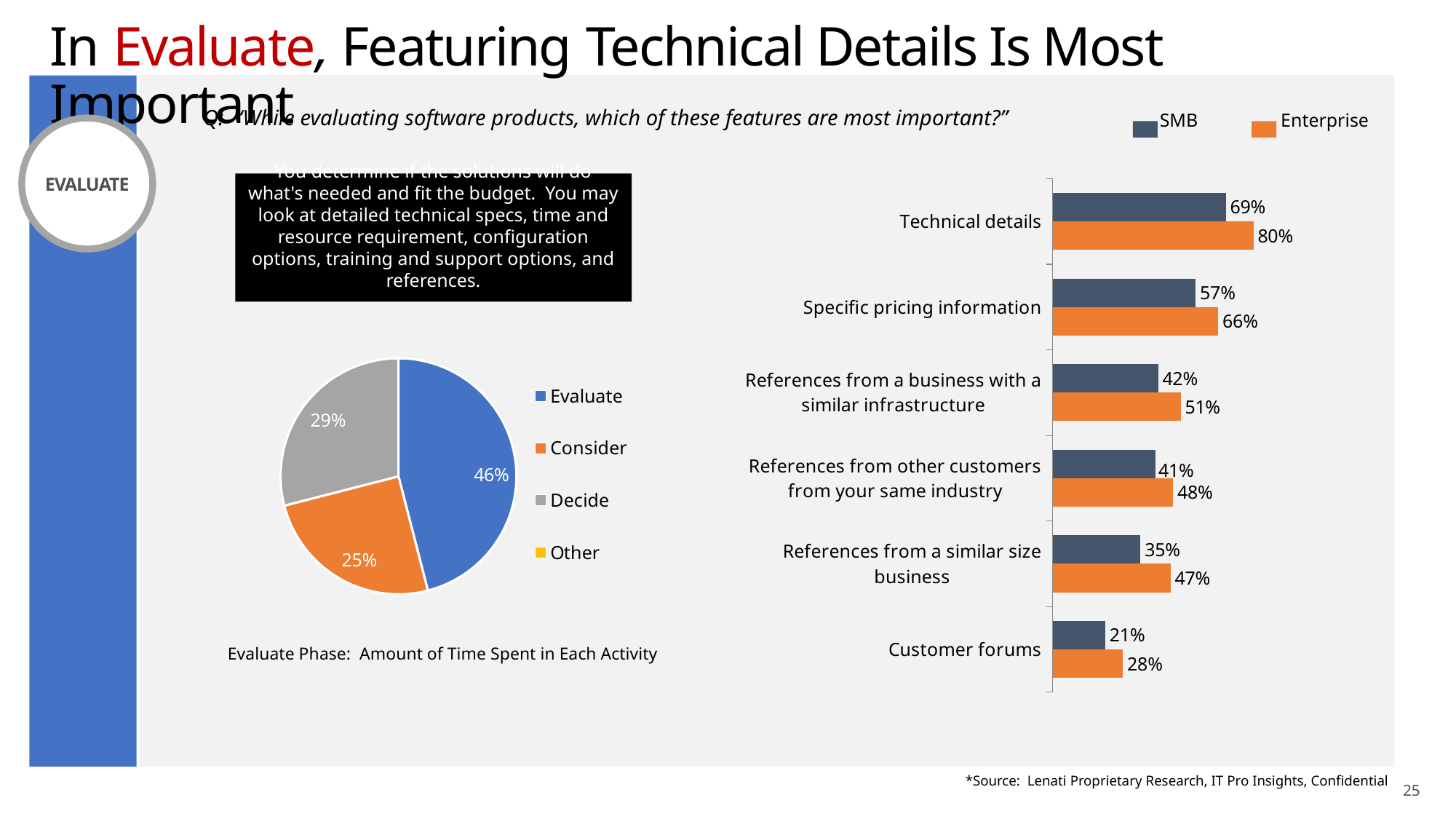
What kind of chart is the chart on the left of the slide? Pie chart In the bar chart on the right, what is the Enterprise value for Technical details? 80% In the pie chart titled 'Evaluate Phase: Amount of Time Spent in Each Activity', which activity has the largest share? Evaluate How many categories does the bar chart on the right show? 6 In the bar chart on the right, what is the SMB value for Customer forums? 21% In the bar chart on the right, which category has the lowest SMB value? Customer forums How many series does the legend of the bar chart on the right list? 2 In the bar chart on the right, what is the SMB value for Specific pricing information? 57% In the bar chart on the right, which category has the highest Enterprise value? Technical details In the pie chart titled 'Evaluate Phase: Amount of Time Spent in Each Activity', what share does Consider have? 25% In the bar chart on the right, which is larger for Specific pricing information: the SMB value or the Enterprise value? Enterprise In the bar chart on the right, what is the difference between the Enterprise and SMB values for References from a similar size business? 12%